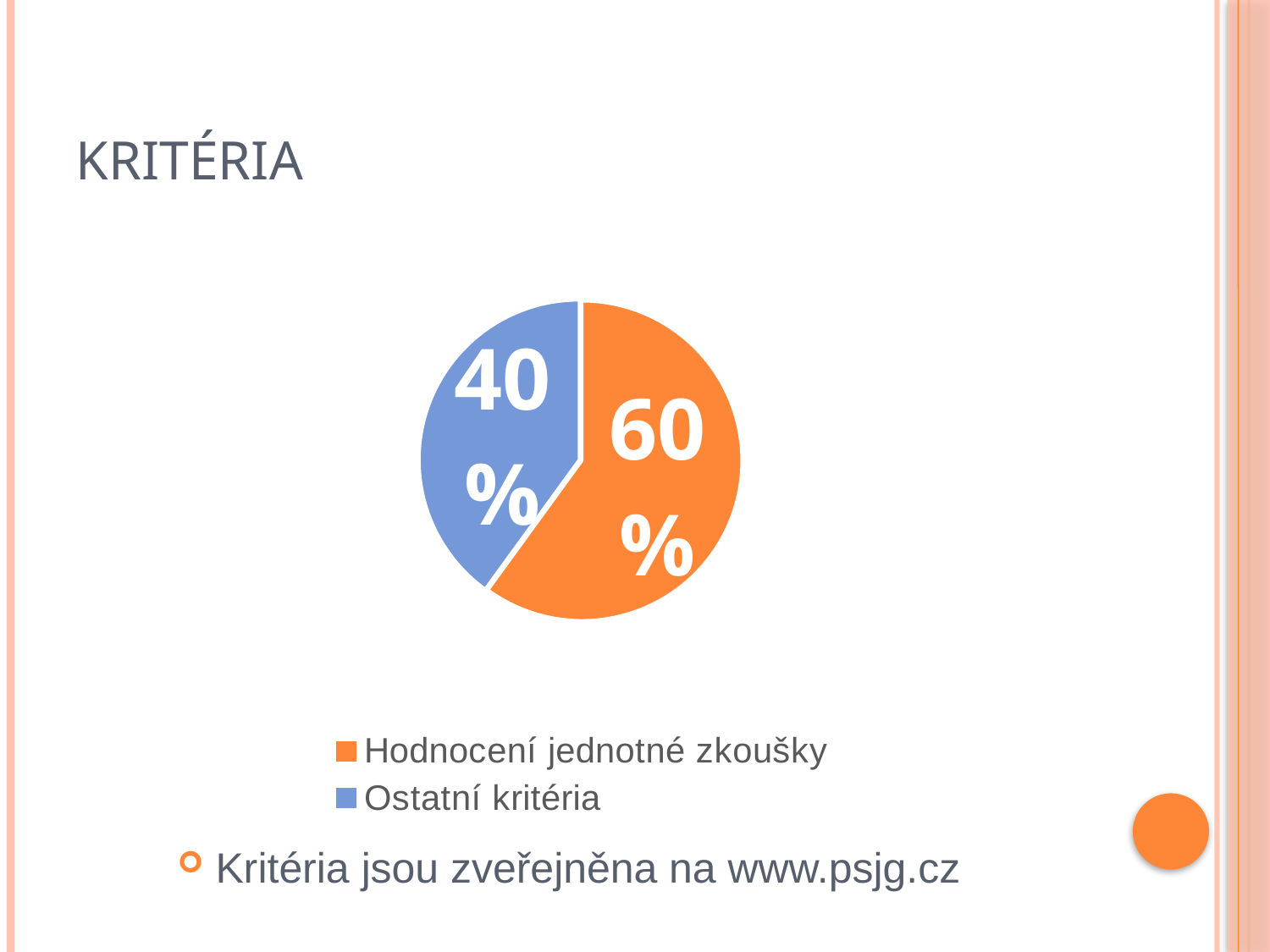
What colour is the slice for "Ostatní kritéria"? Blue What is the difference in percentage points between "Hodnocení jednotné zkoušky" and "Ostatní kritéria"? 20% Which is larger, the slice for "Hodnocení jednotné zkoušky" or the slice for "Ostatní kritéria"? Hodnocení jednotné zkoušky What colour is the slice for "Hodnocení jednotné zkoušky"? Orange Which category has the smallest slice of the pie? Ostatní kritéria How many slices does the pie chart have? 2 What share of the pie does "Ostatní kritéria" represent? 40% How many entries does the legend list? 2 Which category has the largest slice of the pie? Hodnocení jednotné zkoušky What share of the pie does "Hodnocení jednotné zkoušky" represent? 60% What kind of chart is shown on the slide? Pie chart